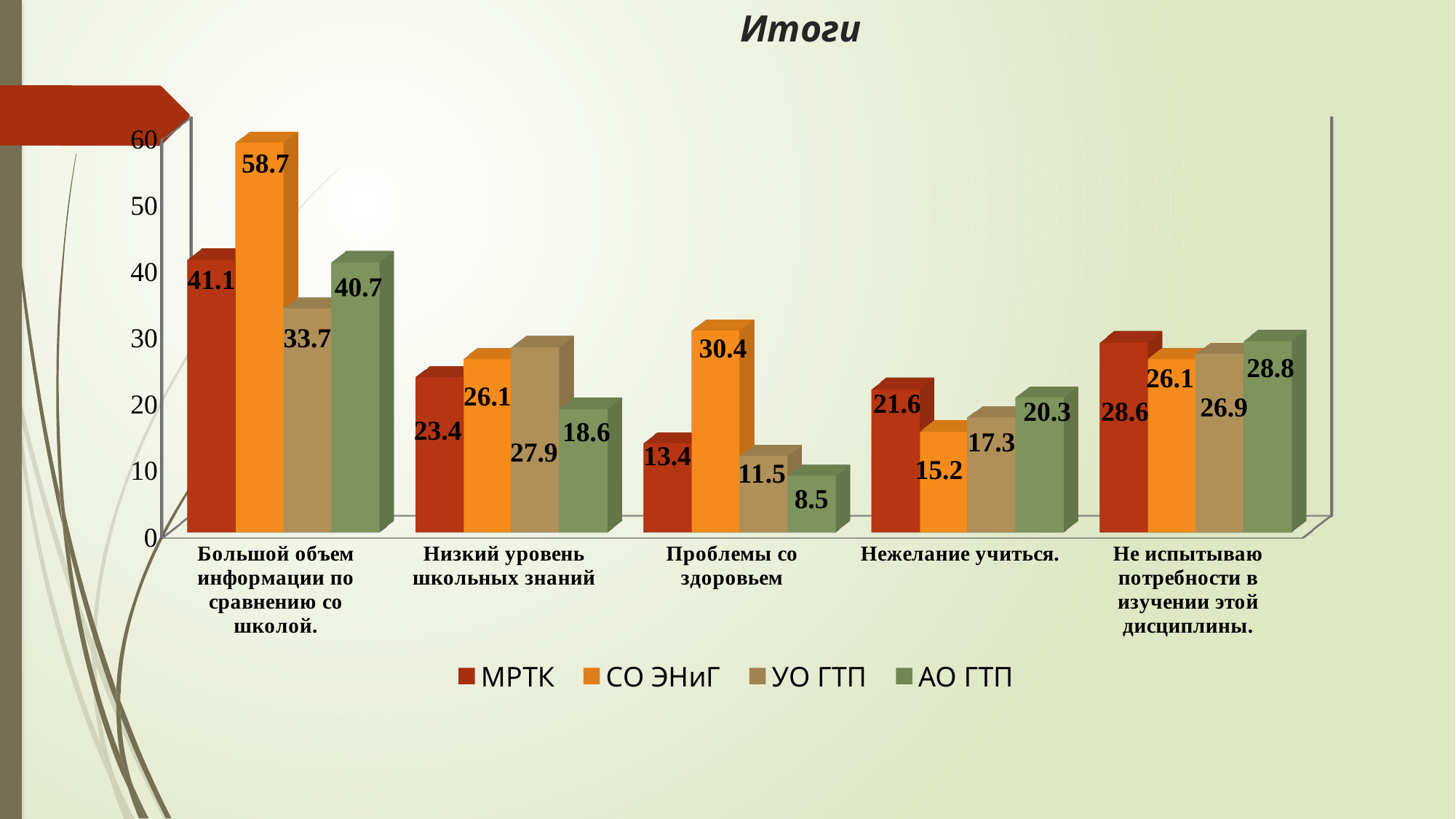
How many categories are shown on the x axis of the chart? 5 What value does the АО ГТП series show for the category "Проблемы со здоровьем"? 8.5 What is the title of the slide? Итоги What value does the МРТК series show for the category "Не испытываю потребности в изучении этой дисциплины"? 28.6 What value does the УО ГТП series show for the category "Нежелание учиться"? 17.3 What value does the СО ЭНиГ series show for the category "Большой объем информации по сравнению со школой"? 58.7 What is the difference between the СО ЭНиГ and МРТК values in the category "Большой объем информации по сравнению со школой"? 17.6 How many series does the legend list? 4 Which series has the lowest value in the category "Проблемы со здоровьем"? АО ГТП In the category "Нежелание учиться", which is larger: the МРТК value or the СО ЭНиГ value? МРТК Which series has the highest value in the category "Низкий уровень школьных знаний"? УО ГТП What kind of chart is shown on the slide? Bar chart